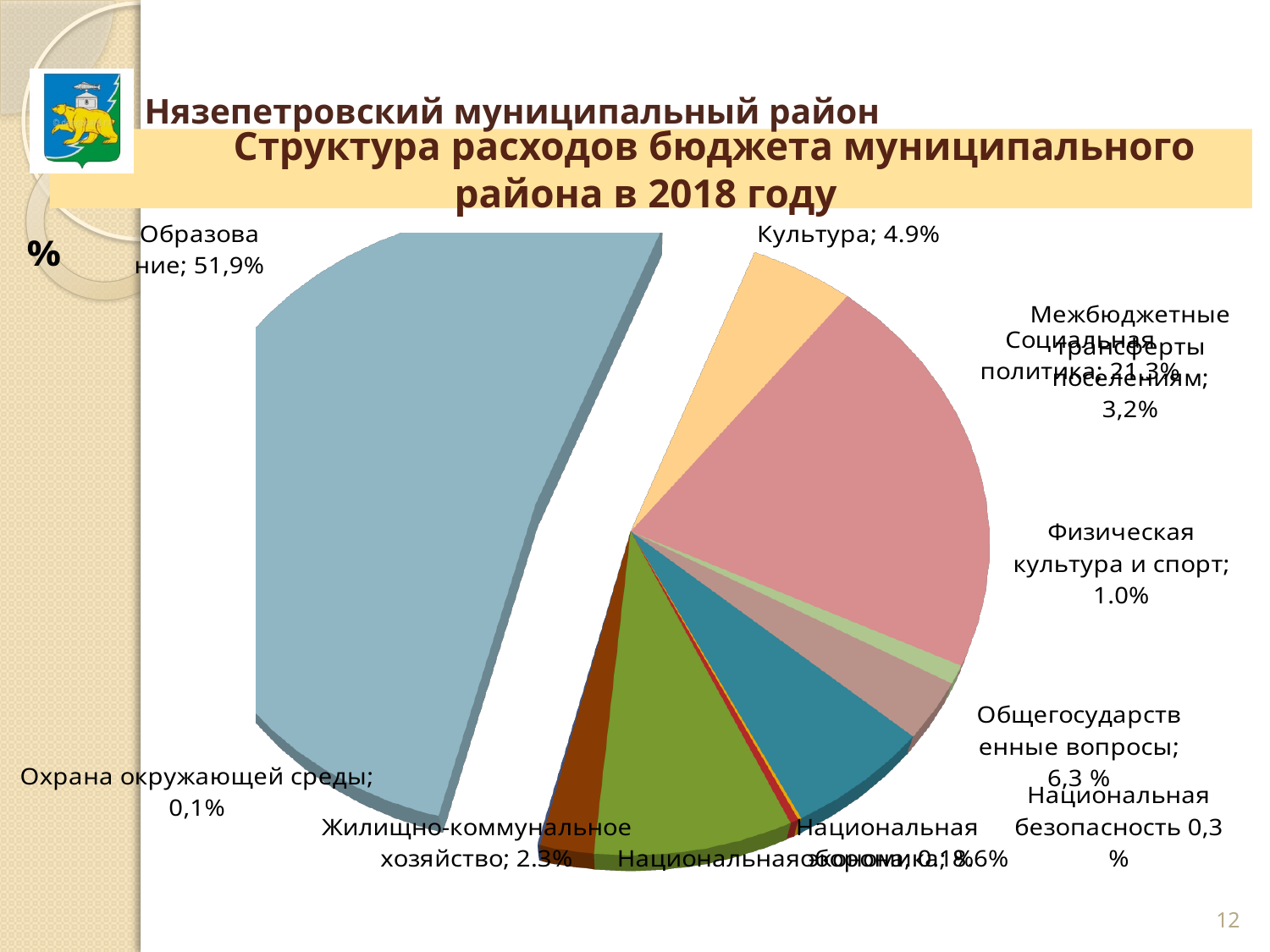
What share of the pie does Образование take? 51,9% What is the value for Социальная политика? 21,3% What is the value for Физическая культура и спорт? 1.0% What kind of chart is shown on the slide? pie chart Which category has the largest share of the pie? Образование Which is larger, Культура or Общегосударственные вопросы? Общегосударственные вопросы What is the value for Культура? 4.9% What is the title of the chart? Структура расходов бюджета муниципального района в 2018 году What is the value for Охрана окружающей среды? 0,1% What is the difference between the shares of Образование and Социальная политика? 30,6% What is the value for Общегосударственные вопросы? 6,3 % What is the value for Жилищно-коммунальное хозяйство? 2.3%